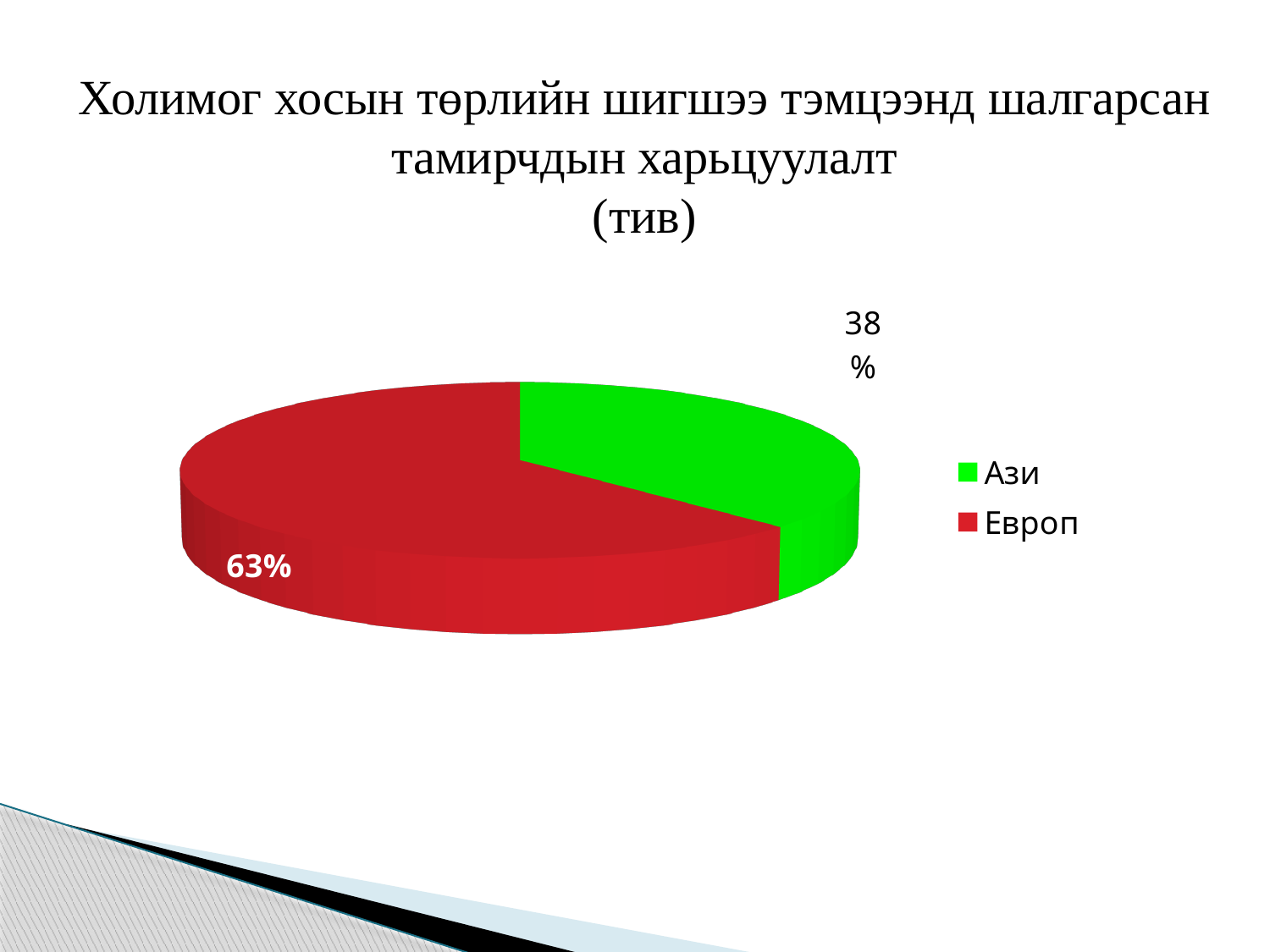
What colour is the slice for Ази? Green Which category has the largest slice of the pie? Европ How many entries does the legend list? 2 What colour is the slice for Европ? Red What share of the pie does Европ (Europe) represent? 63% Which is larger, the share for Ази or the share for Европ? Европ How many slices does the pie chart have? 2 What share of the pie does Ази (Asia) represent? 38% Which category has the smallest slice of the pie? Ази What is the difference in percentage points between the Европ share and the Ази share? 25 What kind of chart is shown on the slide? Pie chart